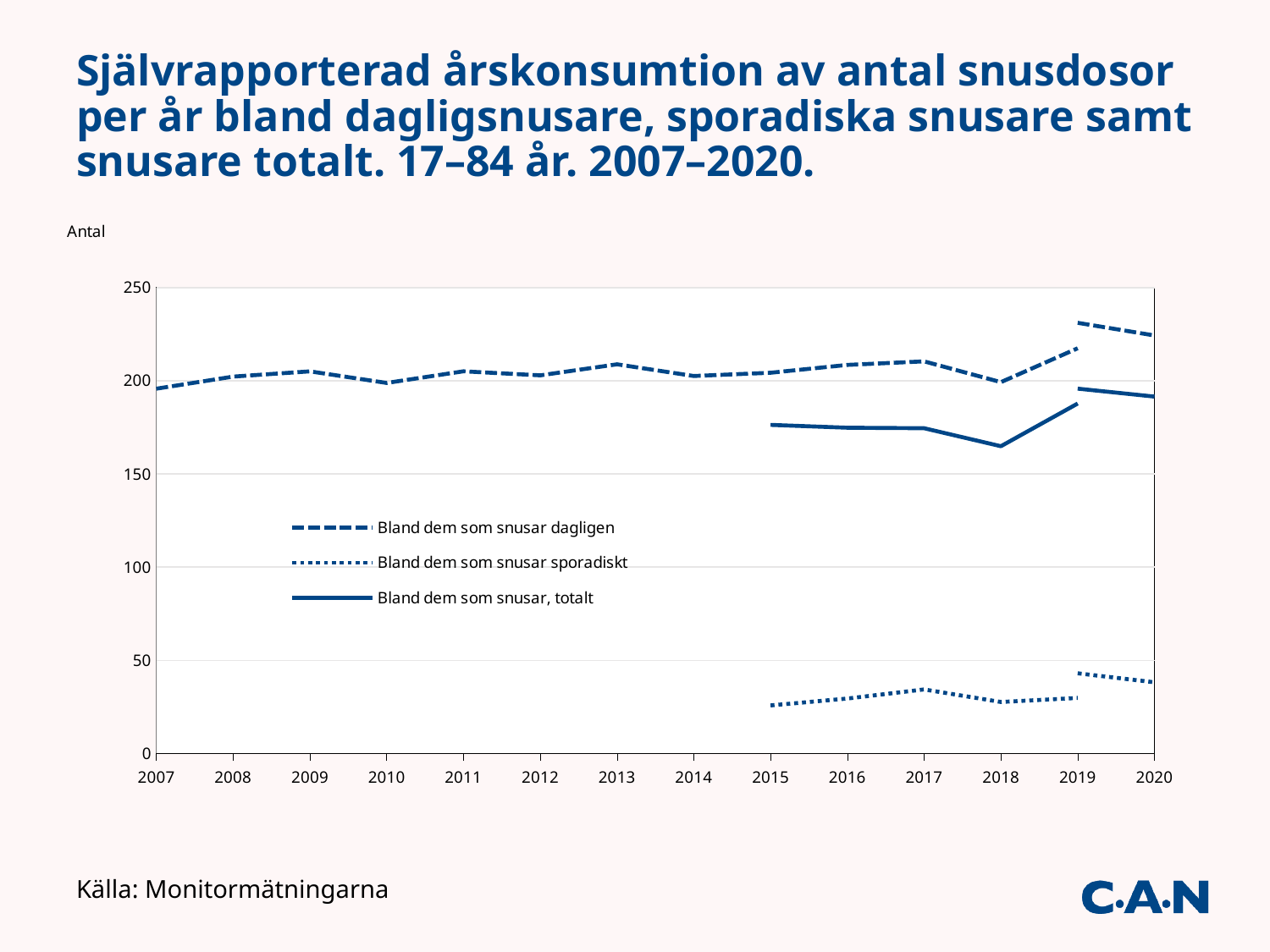
What kind of chart is shown on the slide? line chart How many series does the legend list? 3 Is the value for 'Bland dem som snusar dagligen' in 2019 greater or less than 200? greater In which year does 'Bland dem som snusar, totalt' have its lowest value? 2018 Is the value for 'Bland dem som snusar, totalt' in 2018 greater or less than 200? less Is the value for 'Bland dem som snusar, totalt' in 2015 greater or less than 150? greater What is the label on the y axis of the chart? Antal In 2020, which series has the larger value: 'Bland dem som snusar dagligen' or 'Bland dem som snusar, totalt'? Bland dem som snusar dagligen How many years are shown on the x axis? 14 In which year does 'Bland dem som snusar dagligen' reach its highest value? 2019 Does the value for 'Bland dem som snusar, totalt' rise or fall from 2018 to 2019? rise